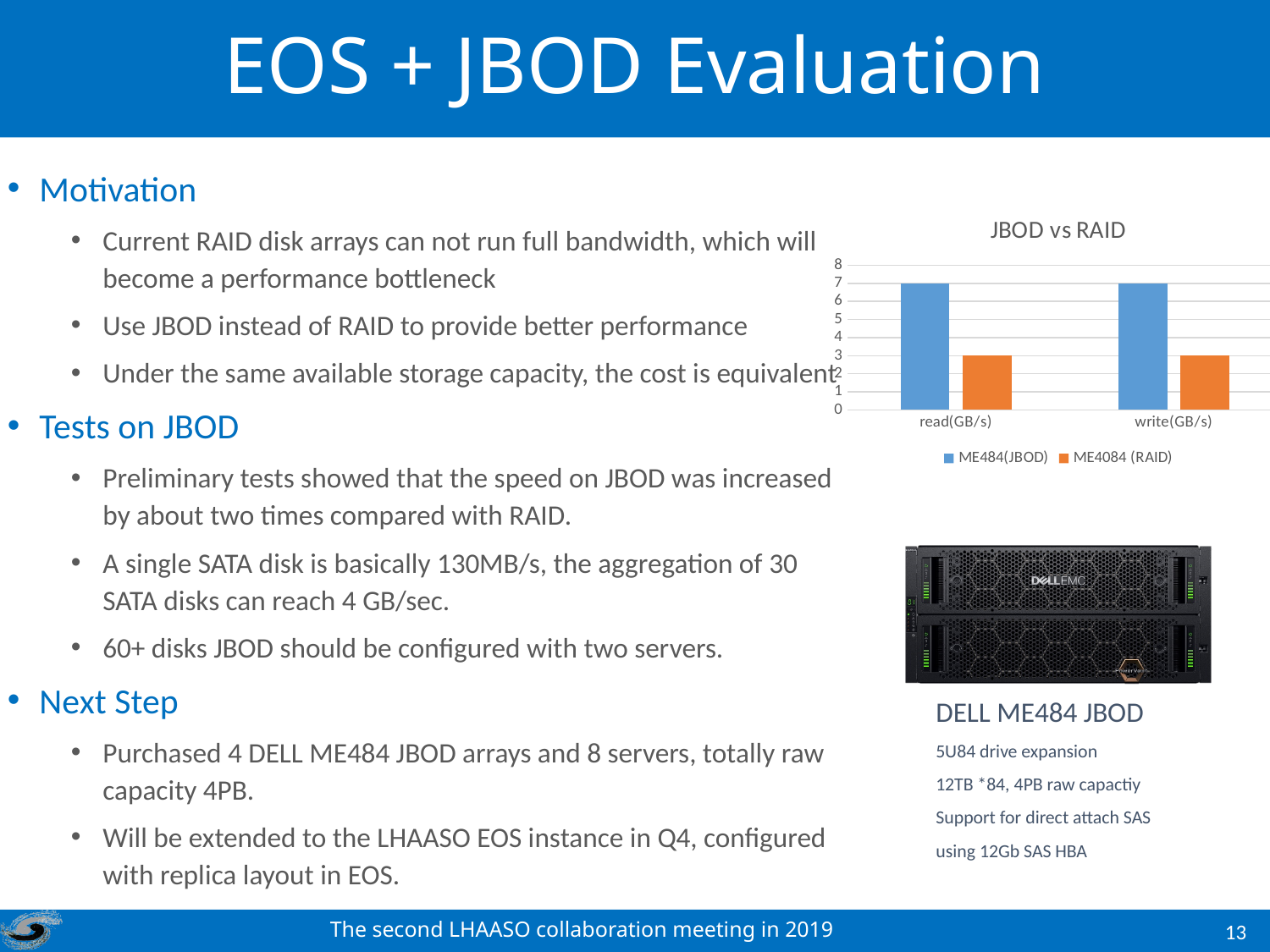
What kind of chart is shown on the slide? bar chart Is the read(GB/s) value for ME484(JBOD) greater or less than 5? greater How many categories are shown on the x axis of the chart? 2 Is the read(GB/s) value for ME4084 (RAID) greater or less than 4? less How many series does the chart legend list? 2 For write(GB/s), which series has the larger value, ME484(JBOD) or ME4084 (RAID)? ME484(JBOD) Is the write(GB/s) value for ME484(JBOD) greater or less than 8? less For read(GB/s), which series has the larger value, ME484(JBOD) or ME4084 (RAID)? ME484(JBOD) What are the two series named in the chart legend? ME484(JBOD) and ME4084 (RAID) What is the title of the chart on the slide? JBOD vs RAID Which series has the lowest value for read(GB/s)? ME4084 (RAID)